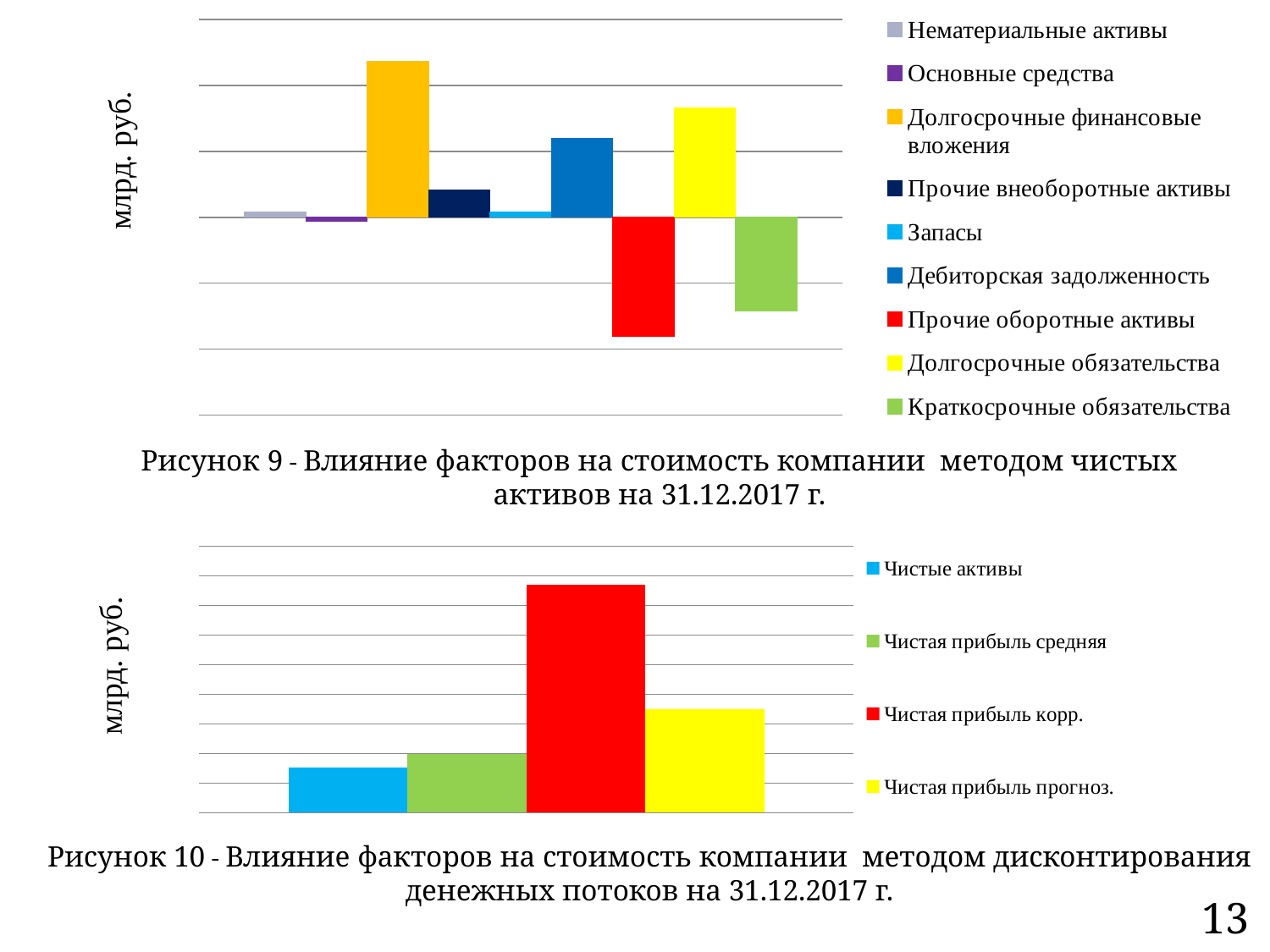
In Рисунок 9 (the top chart), which series has the lowest (most negative) value? Прочие оборотные активы How many series does the legend of Рисунок 10 (the bottom chart) list? 4 In Рисунок 9 (the top chart), which series has the highest value? Долгосрочные финансовые вложения What type of chart is Рисунок 9 (the top chart)? bar chart What type of chart is Рисунок 10 (the bottom chart)? bar chart In Рисунок 10 (the bottom chart), which series has the highest value? Чистая прибыль корр. How many series does the legend of Рисунок 9 (the top chart) list? 9 In Рисунок 10 (the bottom chart), which series has the lowest value? Чистые активы In Рисунок 9 (the top chart), which is larger: Долгосрочные финансовые вложения or Долгосрочные обязательства? Долгосрочные финансовые вложения In Рисунок 9 (the top chart), which is larger: Дебиторская задолженность or Прочие внеоборотные активы? Дебиторская задолженность What is the vertical axis title of Рисунок 9 (the top chart)? млрд. руб. In Рисунок 10 (the bottom chart), which is larger: Чистая прибыль средняя or Чистая прибыль прогноз.? Чистая прибыль прогноз.